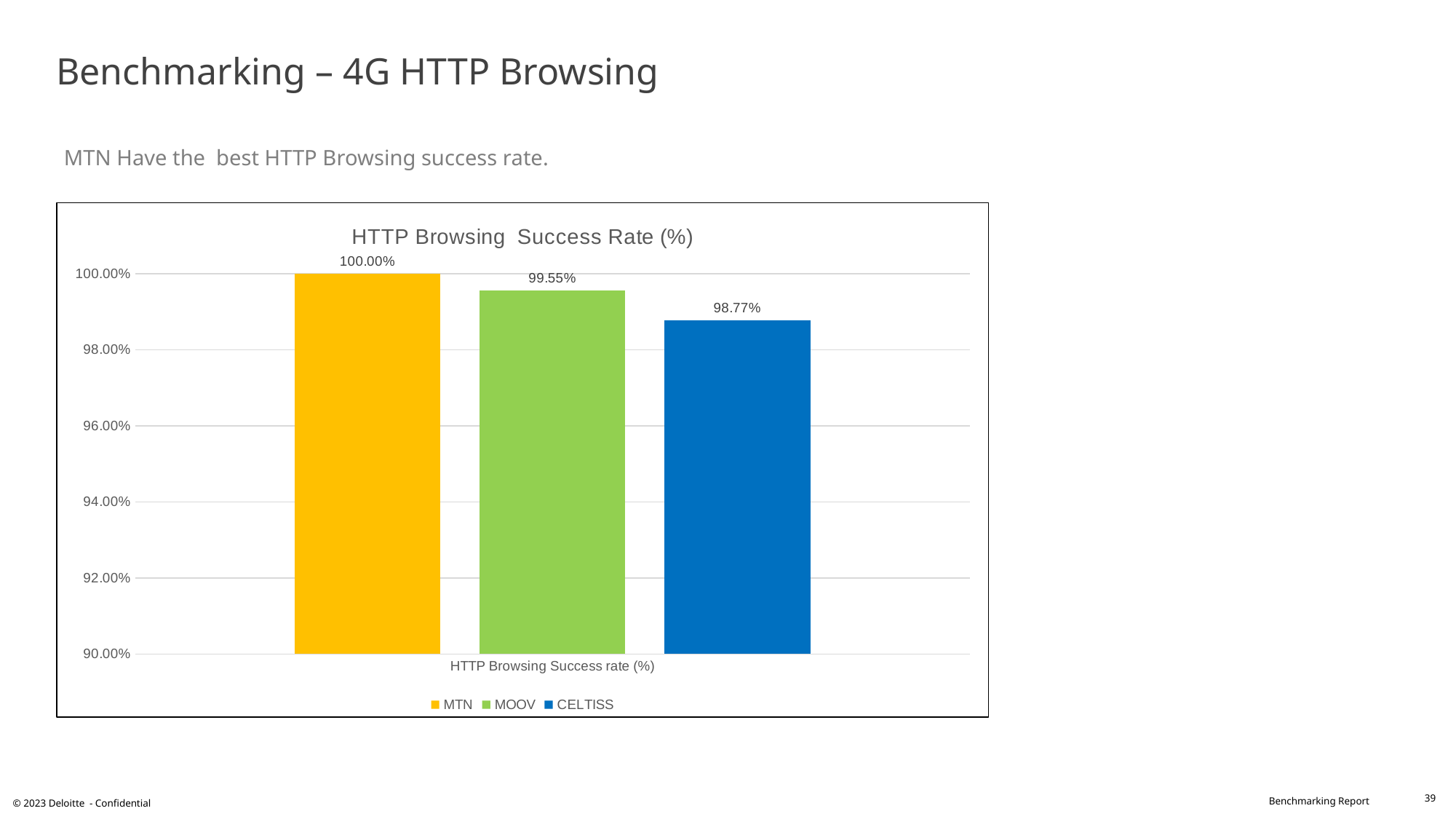
Which operator has the highest HTTP Browsing success rate? MTN What is the difference between the HTTP Browsing success rates of MOOV and CELTISS? 0.78% What is the HTTP Browsing success rate for MOOV? 99.55% What is the difference between the HTTP Browsing success rates of MTN and CELTISS? 1.23% What is the HTTP Browsing success rate for CELTISS? 98.77% What is the title of the chart? HTTP Browsing Success Rate (%) What kind of chart is shown on the slide? Bar chart Which has a higher HTTP Browsing success rate, MOOV or CELTISS? MOOV Is the HTTP Browsing success rate for CELTISS greater or less than 98.00%? greater Which operator has the lowest HTTP Browsing success rate? CELTISS What is the HTTP Browsing success rate for MTN? 100.00% How many series does the legend list? 3